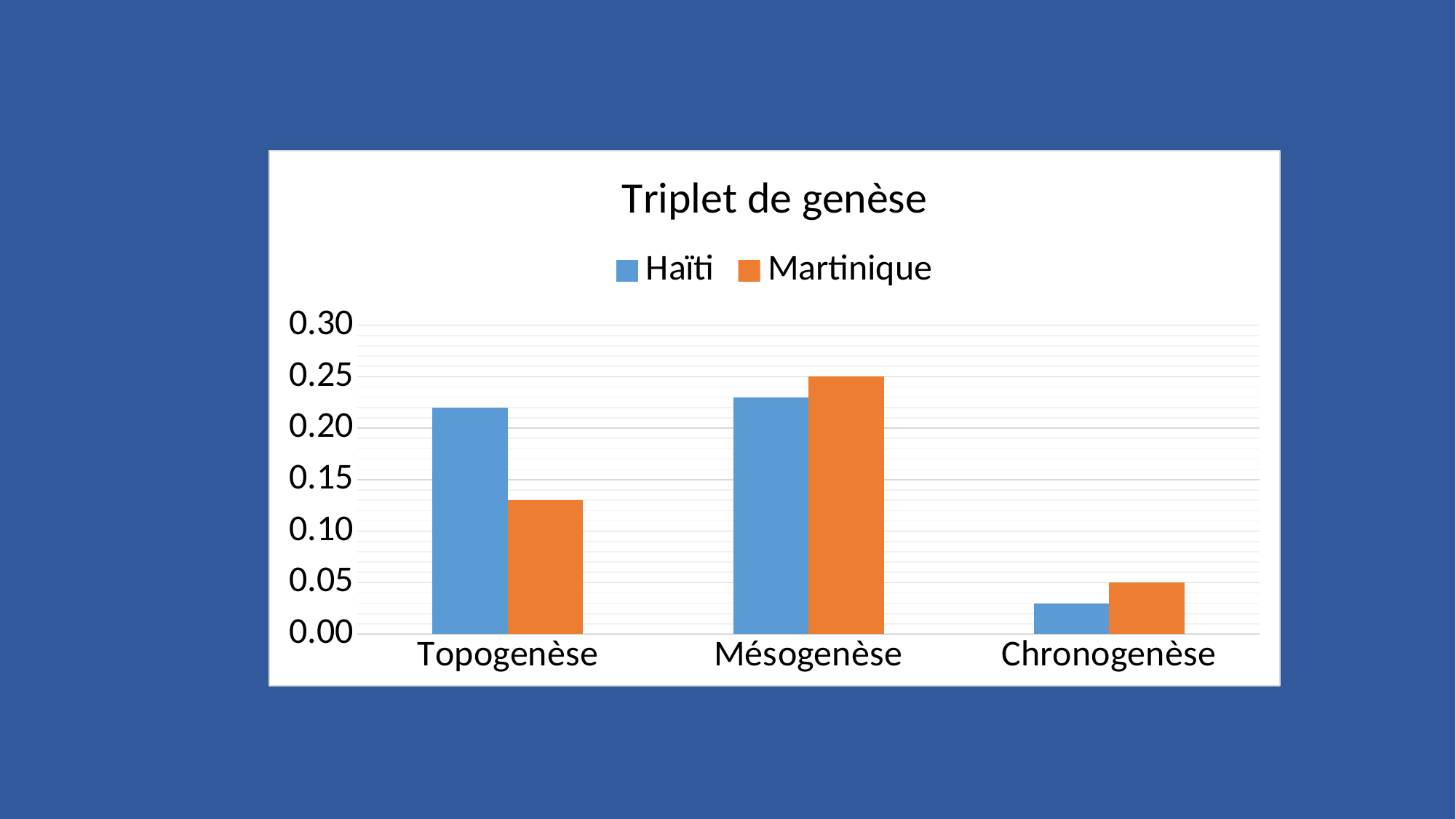
Which category has the lowest Haïti value? Chronogenèse How many categories are shown on the x axis? 3 For Topogenèse, which series has the larger value, Haïti or Martinique? Haïti What type of chart is shown on the slide? bar chart For Chronogenèse, which series has the larger value, Haïti or Martinique? Martinique How many series does the legend list? 2 Is the Haïti value for Chronogenèse greater or less than 0.05? less Which category has the highest Martinique value? Mésogenèse Is the Haïti value for Topogenèse greater or less than 0.20? greater What is the title of the chart? Triplet de genèse Which series is shown in orange? Martinique Is the Martinique value for Topogenèse greater or less than 0.15? less